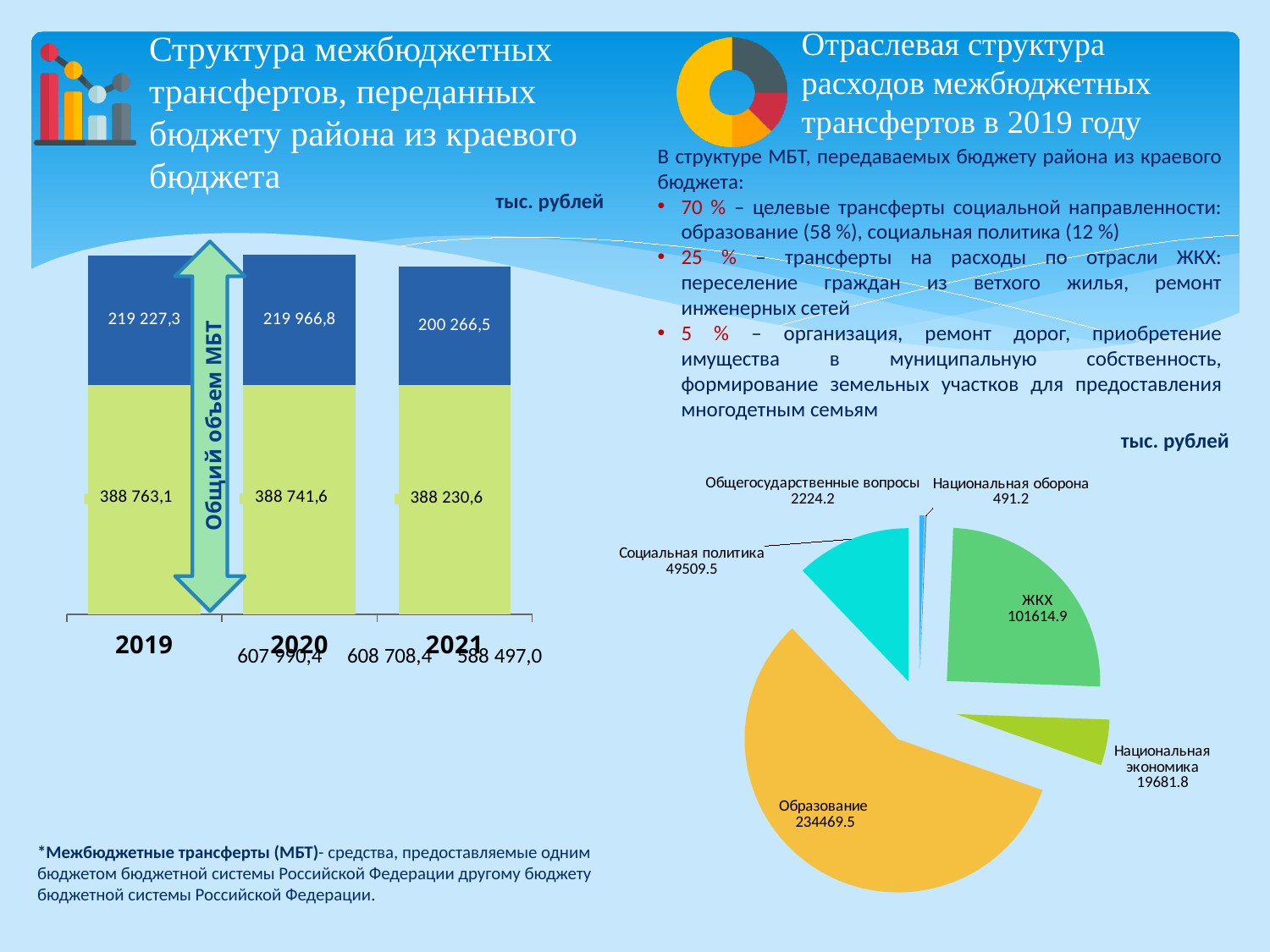
How many years are shown on the left bar chart? 3 How many slices does the pie chart on the right have? 6 On the left bar chart, what is the value of the green (lower) segment for 2021? 388 230,6 On the pie chart, which is larger: Социальная политика or Национальная экономика? Социальная политика On the left bar chart, what is the value of the blue (upper) segment for 2020? 219 966,8 On the left bar chart, what is the total value of the 2019 bar? 607 990,4 On the left bar chart, what is the difference between the blue segment values for 2020 and 2021? 19 700,3 On the left bar chart, which year has the lowest total? 2021 On the pie chart, which category has the largest slice? Образование What kind of chart is the left chart showing transfers for 2019, 2020 and 2021? bar chart What kind of chart is the right chart titled 'Отраслевая структура расходов межбюджетных трансфертов в 2019 году'? pie chart On the pie chart, what is the value for ЖКХ? 101614.9